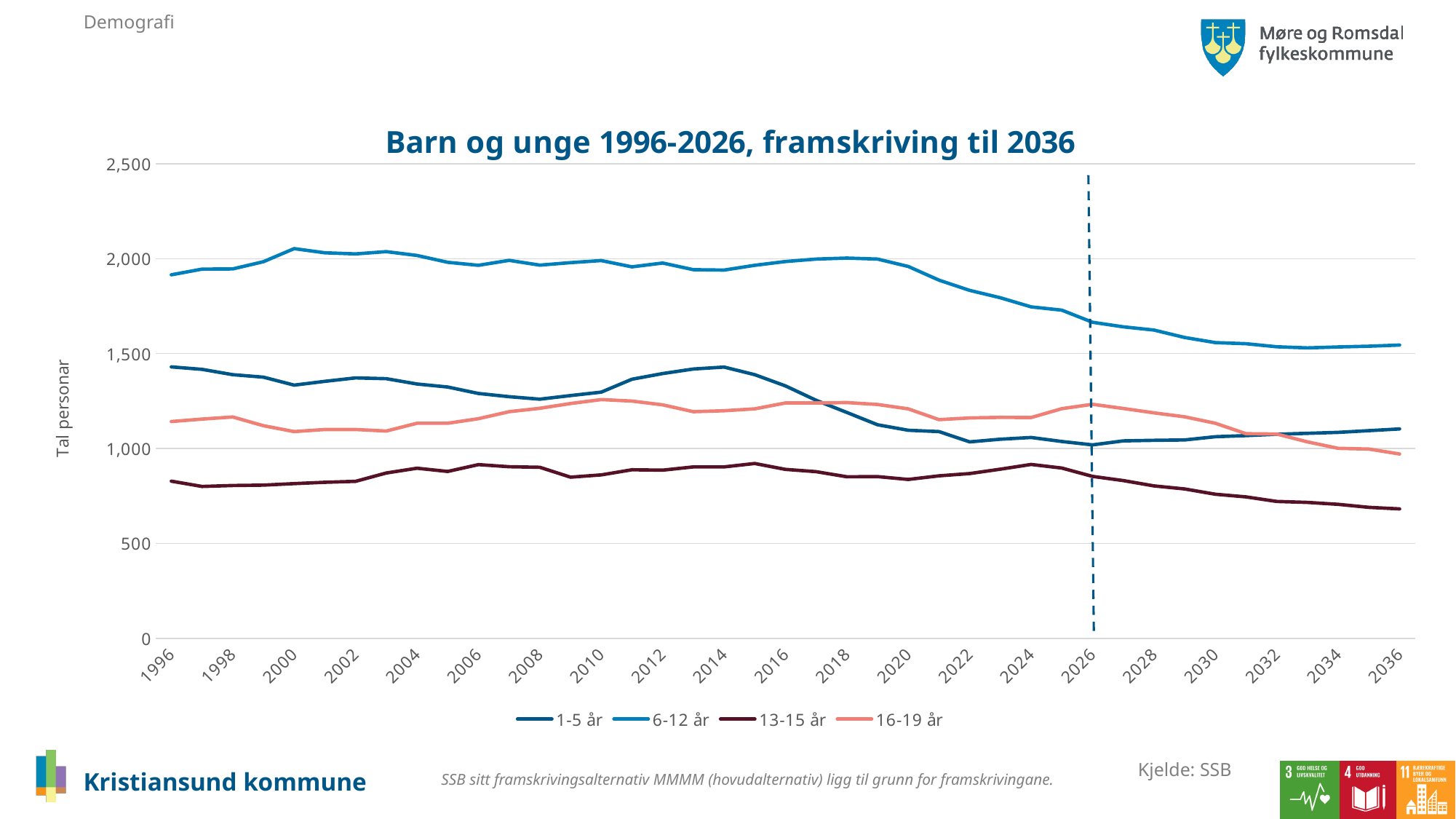
In 2020, which is larger: the value for 1-5 år or the value for 16-19 år? 16-19 år Does the 6-12 år series rise or fall between 2020 and 2036? Fall What is the label on the vertical axis? Tal personar Is the value for 13-15 år in 2036 greater or less than 1,000? less Which series has the lowest values across the whole period? 13-15 år What is the title of the chart? Barn og unge 1996-2026, framskriving til 2036 How many series does the legend list? 4 Is the value for 1-5 år in 1996 greater or less than 1,500? less In 1996, which is larger: the value for 1-5 år or the value for 16-19 år? 1-5 år Is the value for 6-12 år in 2000 greater or less than 2,000? greater What kind of chart is shown on the slide? Line chart Which series has the highest values across the whole period? 6-12 år